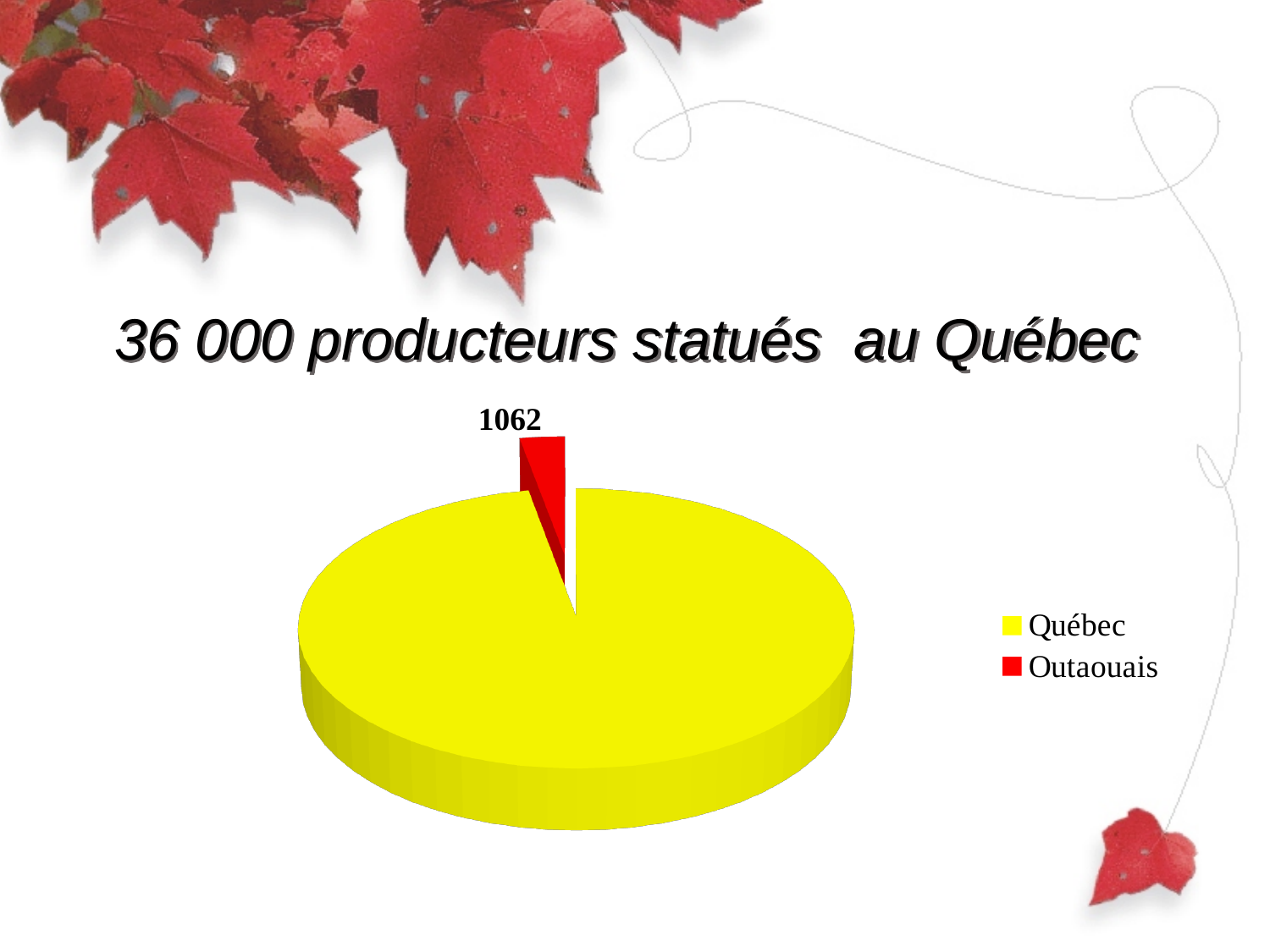
How many slices does the pie chart have? 2 What colour is the Outaouais slice in the pie chart? Red What colour is the Québec slice in the pie chart? Yellow What value is shown for the Outaouais slice of the pie chart? 1062 Which category has the largest slice in the pie chart? Québec What kind of chart is shown on the slide? Pie chart How many entries does the legend of the pie chart list? 2 Which category has the smallest slice in the pie chart? Outaouais Which slice is larger, Québec or Outaouais? Québec